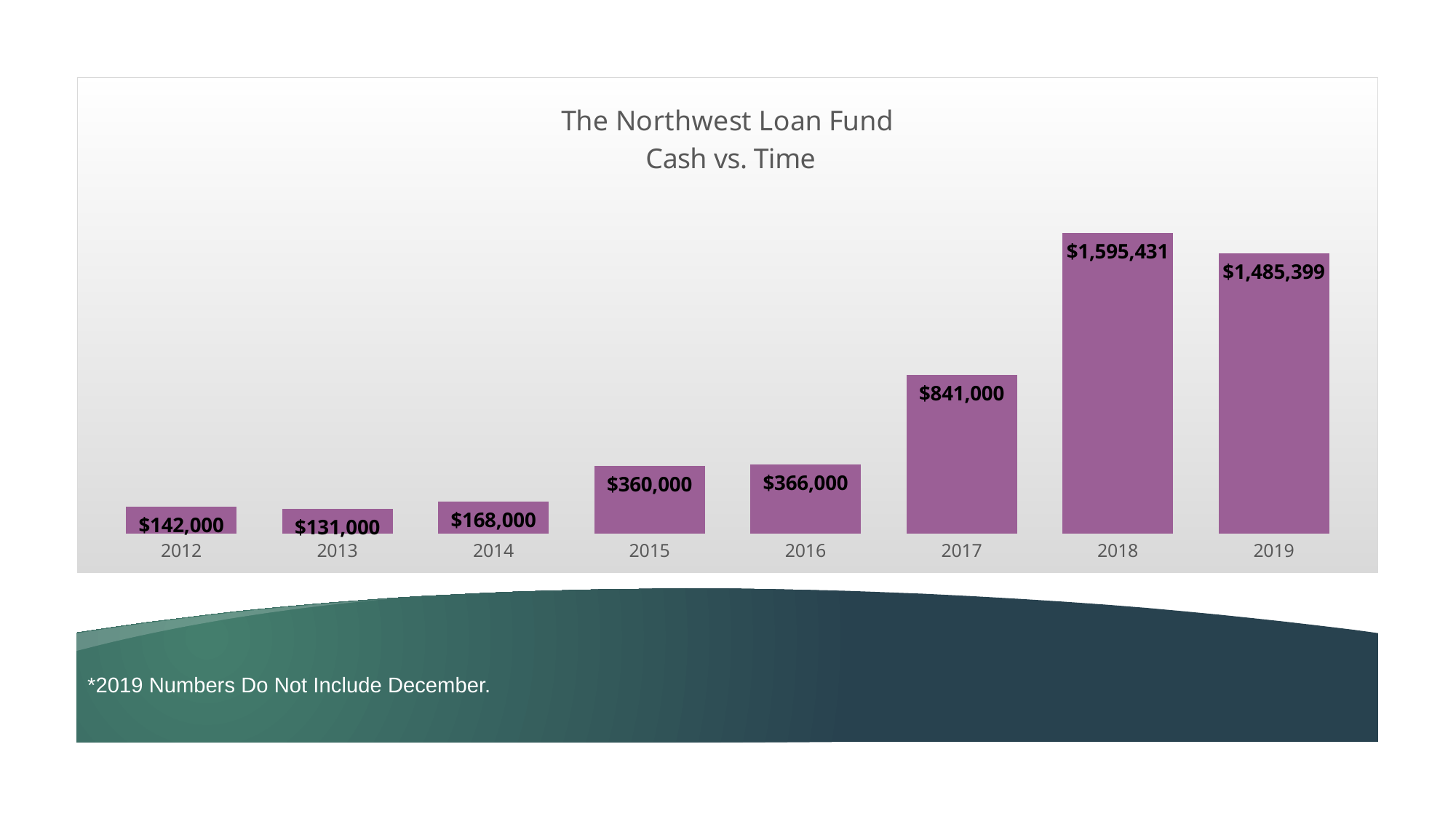
What is the value for 2013? $131,000 What is the difference between the values for 2018 and 2019? $110,032 What is the value for 2017? $841,000 Which year has the lowest value? 2013 What kind of chart is this? Bar chart Do the values generally rise or fall from 2013 to 2018? Rise Which year has the highest value? 2018 What is the title of the chart? The Northwest Loan Fund Cash vs. Time What is the difference between the values for 2017 and 2016? $475,000 How many years are shown on the x axis? 8 What is the value for 2018? $1,595,431 Which is larger, the value for 2014 or the value for 2012? 2014